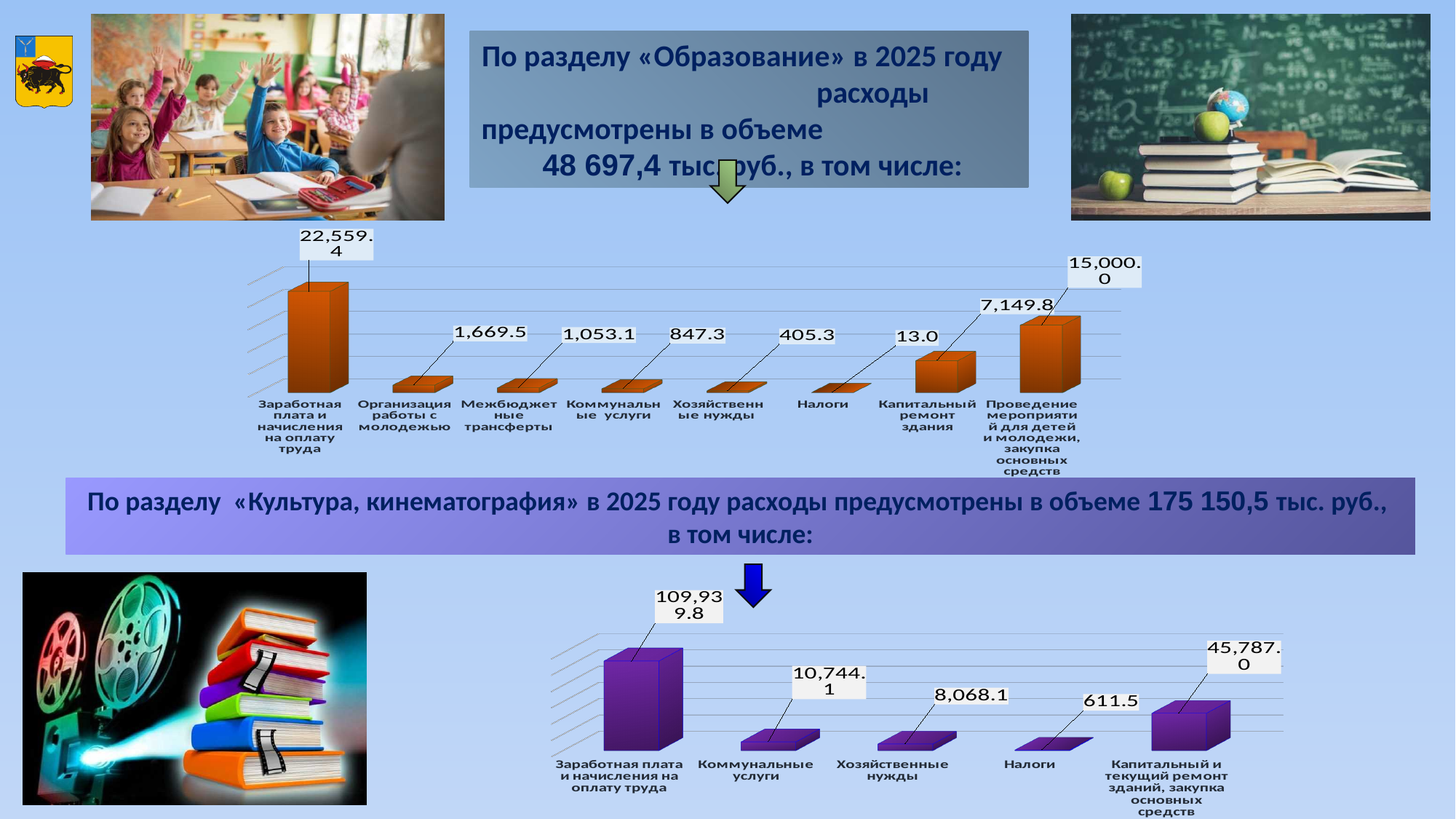
In the bottom chart (Культура, кинематография), what is the difference between Коммунальные услуги and Хозяйственные нужды? 2,676.0 In the bottom chart (Культура, кинематография), what is the value for Капитальный и текущий ремонт зданий, закупка основных средств? 45,787.0 What type of chart is the bottom chart (Культура, кинематография)? Bar chart In the bottom chart (Культура, кинематография), what is the value for Налоги? 611.5 In the top chart (Образование), what is the value for Заработная плата и начисления на оплату труда? 22,559.4 In the top chart (Образование), which is larger: Коммунальные услуги or Хозяйственные нужды? Коммунальные услуги In the top chart (Образование), what is the difference between Заработная плата и начисления на оплату труда and Проведение мероприятий для детей и молодежи, закупка основных средств? 7,559.4 In the top chart (Образование), what is the value for Капитальный ремонт здания? 7,149.8 In the bottom chart (Культура, кинематография), how many categories are shown? 5 In the bottom chart (Культура, кинематография), which category has the highest value? Заработная плата и начисления на оплату труда In the top chart (Образование), which category has the lowest value? Налоги In the top chart (Образование), how many categories are shown? 8